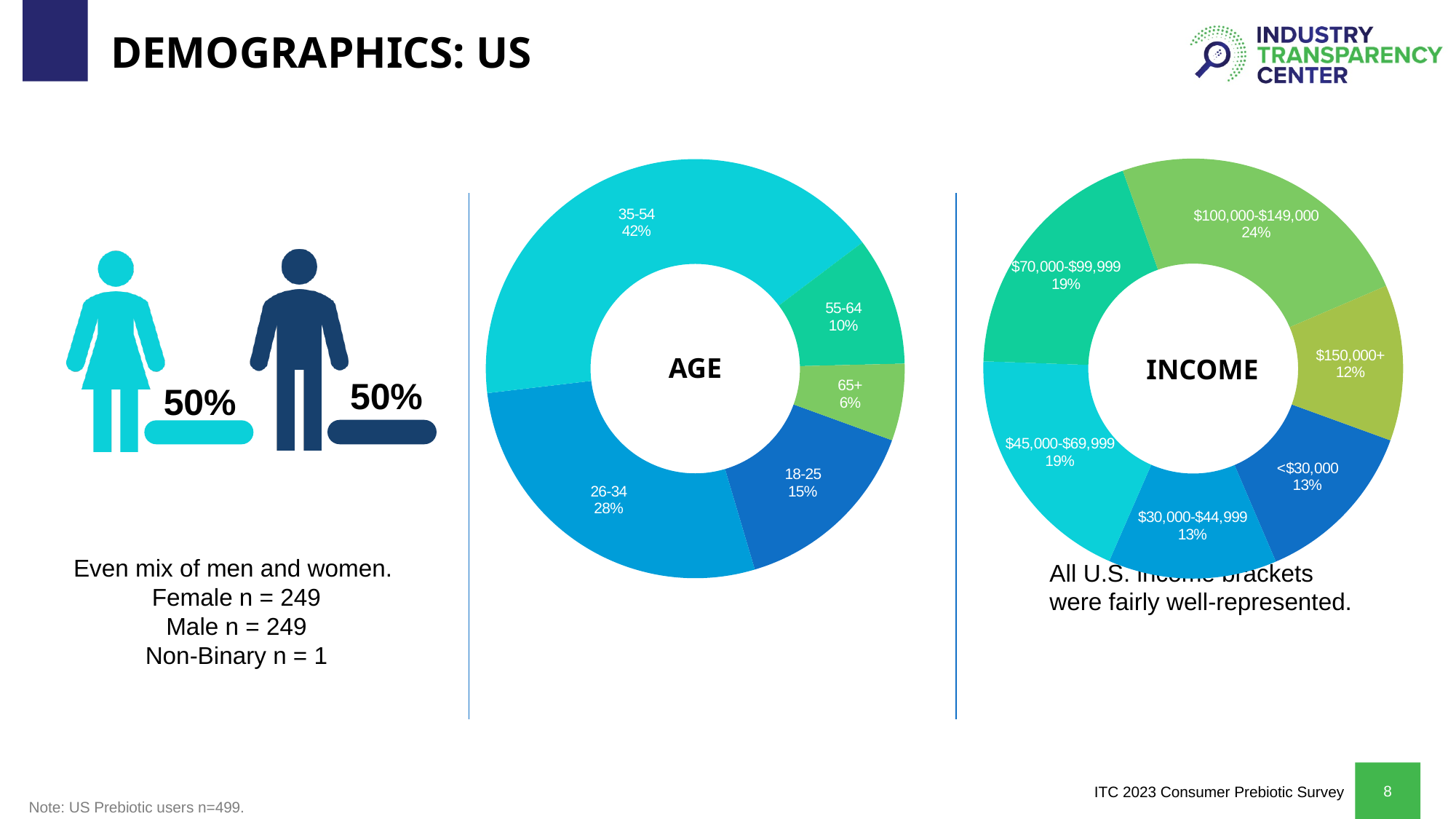
How many income brackets are shown in the INCOME chart? 6 In the INCOME chart, what share of respondents earn $150,000+? 12% In the AGE chart, what is the difference in percentage points between the 26-34 and 18-25 groups? 13 In the INCOME chart, which is larger: the share for $70,000-$99,999 or the share for <$30,000? $70,000-$99,999 In the INCOME chart, what share of respondents earn $100,000-$149,000? 24% In the AGE chart, which age group has the smallest share? 65+ In the AGE chart, which age group has the largest share? 35-54 In the INCOME chart, which income bracket has the largest share? $100,000-$149,000 In the AGE chart, what share of respondents are aged 35-54? 42% How many age groups are shown in the AGE chart? 5 What kind of chart is the AGE chart? Doughnut chart In the AGE chart, what share of respondents are aged 65+? 6%